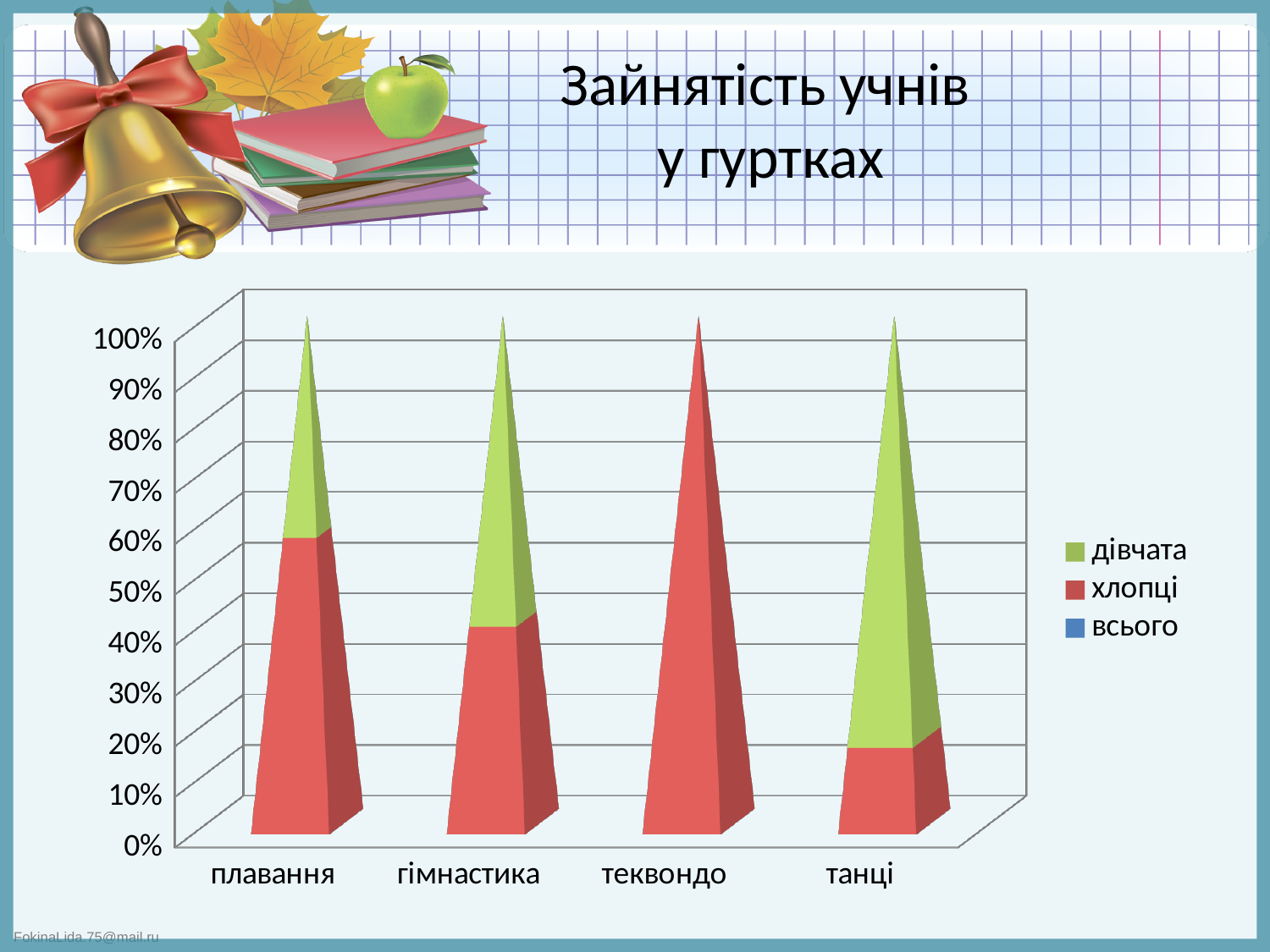
Is the share for хлопці in плавання greater or less than 50%? greater How many series does the chart legend list? 3 Which colour represents the series дівчата in the chart? green Which category has the smallest share for хлопці? танці Which category has the largest share for хлопці? теквондо How many categories are shown on the x axis of the chart? 4 What is the title of the chart on the slide? Зайнятість учнів у гуртках Is the share for хлопці in танці greater or less than 30%? less Is the share for хлопці in гімнастика greater or less than 50%? less What kind of chart is shown on the slide? bar chart Which is larger: the share for хлопці in плавання or in гімнастика? плавання Which category has the largest share for дівчата? танці